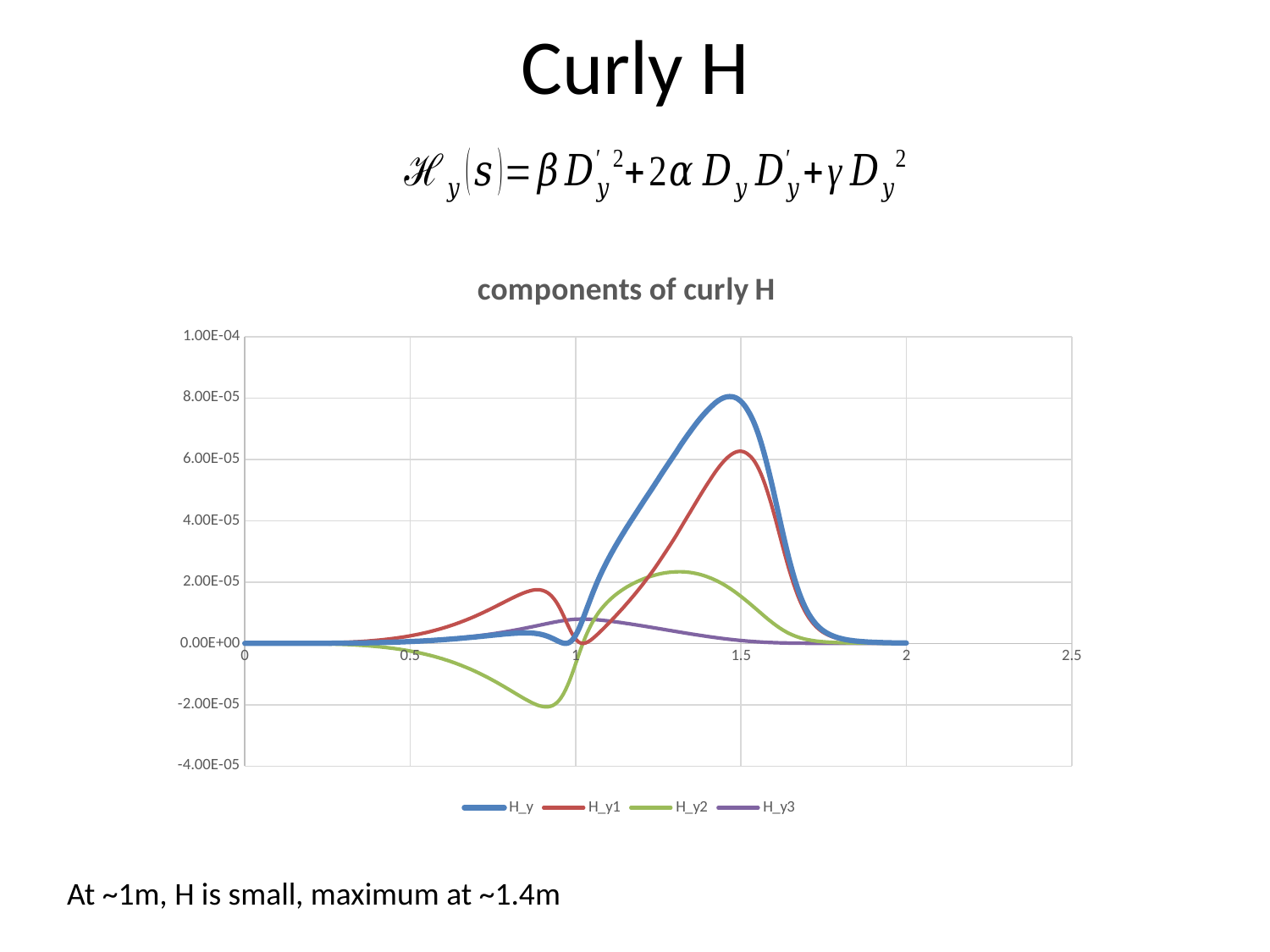
Is the peak value of H_y3 greater or less than 2.00E-05? less Is the minimum value of H_y2 greater or less than 0.00E+00? less Which series reaches the highest peak value on the chart? H_y Which series dips to the lowest (most negative) value on the chart? H_y2 Is the peak value of H_y greater or less than 6.00E-05? greater What kind of chart is shown on the slide? line chart Which series has the larger peak value, H_y1 or H_y2? H_y1 How many series does the legend of the chart list? 4 Which series is drawn with the thick blue line? H_y What is the title of the chart? components of curly H